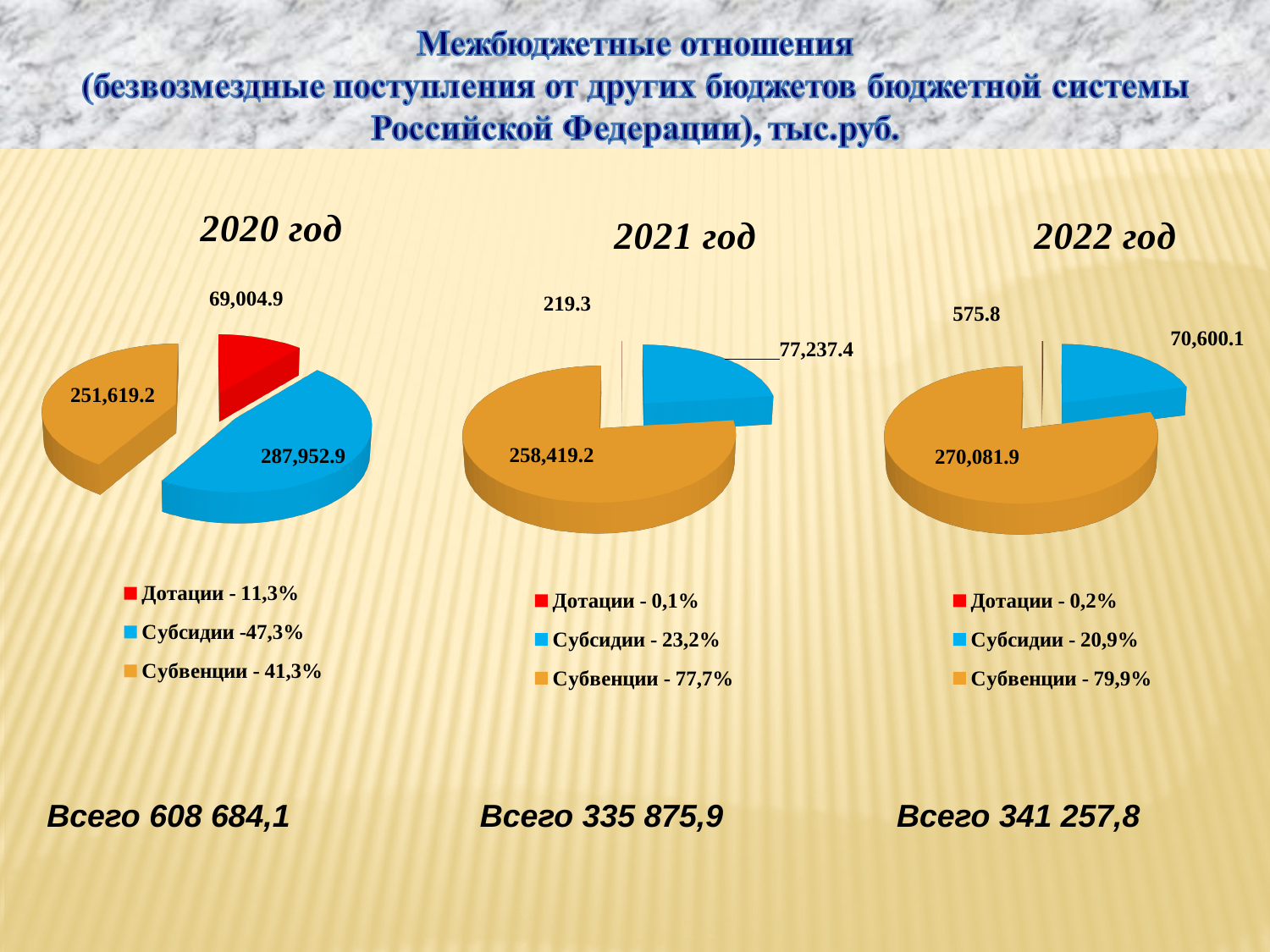
How many categories does the legend of the 2020 год chart list? 3 In the 2020 год pie chart, which category has the largest value? Субсидии In the 2022 год pie chart, what share of the pie does Субвенции represent according to the legend? 79,9% What type of chart is used for the 2021 год data? Pie chart In the 2022 год pie chart, what is the value for Дотации? 575.8 In the 2021 год pie chart, what is the value for Субвенции? 258,419.2 In the 2020 год pie chart, what is the value for Субсидии? 287,952.9 In the 2022 год pie chart, what is the difference between the values for Субвенции and Субсидии? 199,481.8 In the 2021 год pie chart, which category has the smallest value? Дотации In the 2021 год pie chart, what share of the pie does Субсидии represent according to the legend? 23,2% In the 2020 год pie chart, what is the difference between the values for Субсидии and Субвенции? 36,333.7 In the 2022 год pie chart, which is larger: Субсидии or Субвенции? Субвенции